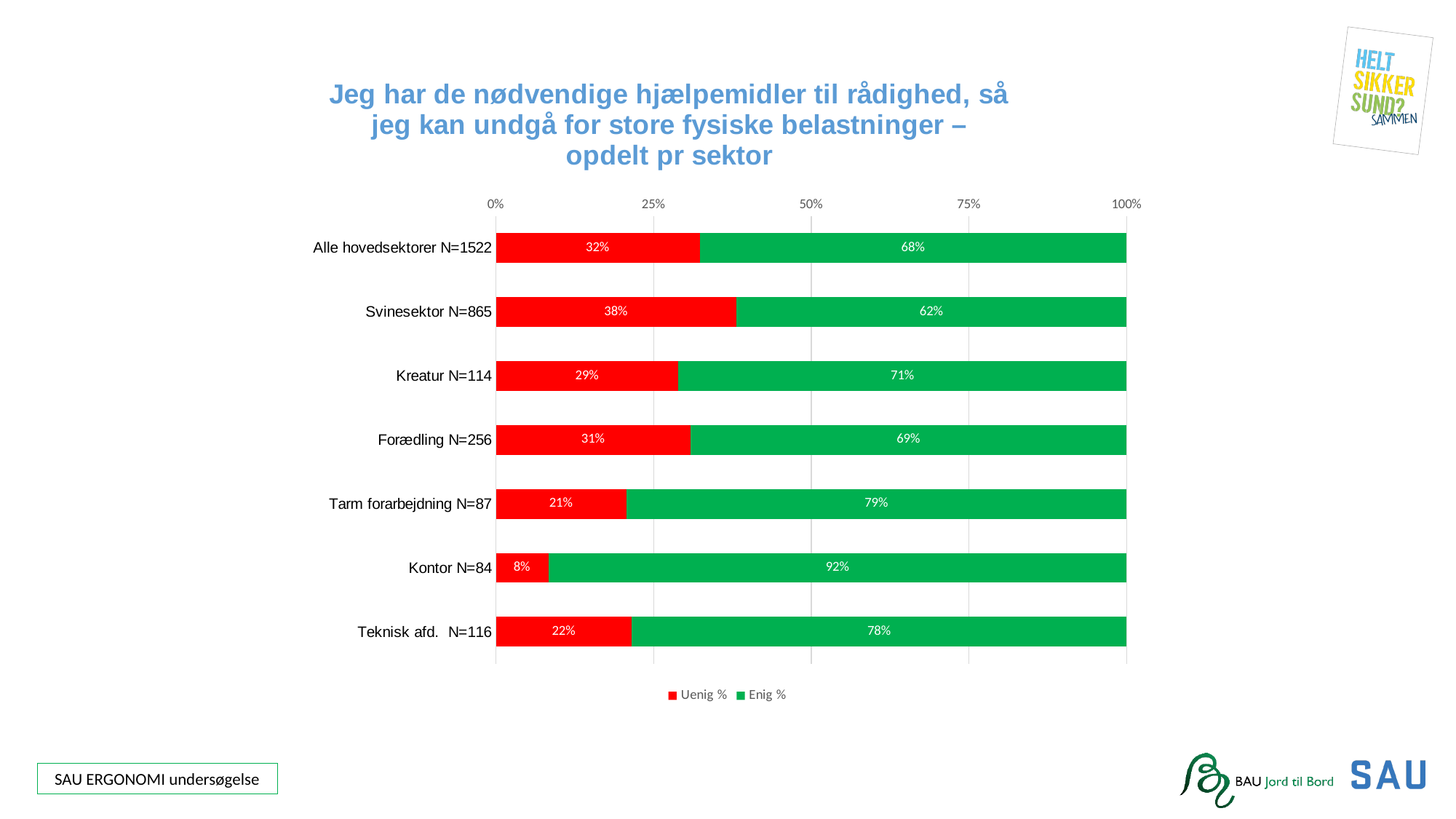
Which category has the highest Uenig % value? Svinesektor N=865 What colour represents the Enig % series? Green Is the Enig % value for Forædling N=256 greater or less than 50%? greater What is the Enig % value for Kontor N=84? 92% How many categories are shown on the chart? 7 What kind of chart is shown on the slide? Stacked bar chart Which category has the lowest Enig % value? Svinesektor N=865 What is the Uenig % value for Svinesektor N=865? 38% What is the difference between the Enig % values for Kontor N=84 and Alle hovedsektorer N=1522? 24% Which has a larger Uenig % value, Kreatur N=114 or Teknisk afd. N=116? Kreatur N=114 How many series does the legend list? 2 What is the Enig % value for Tarm forarbejdning N=87? 79%